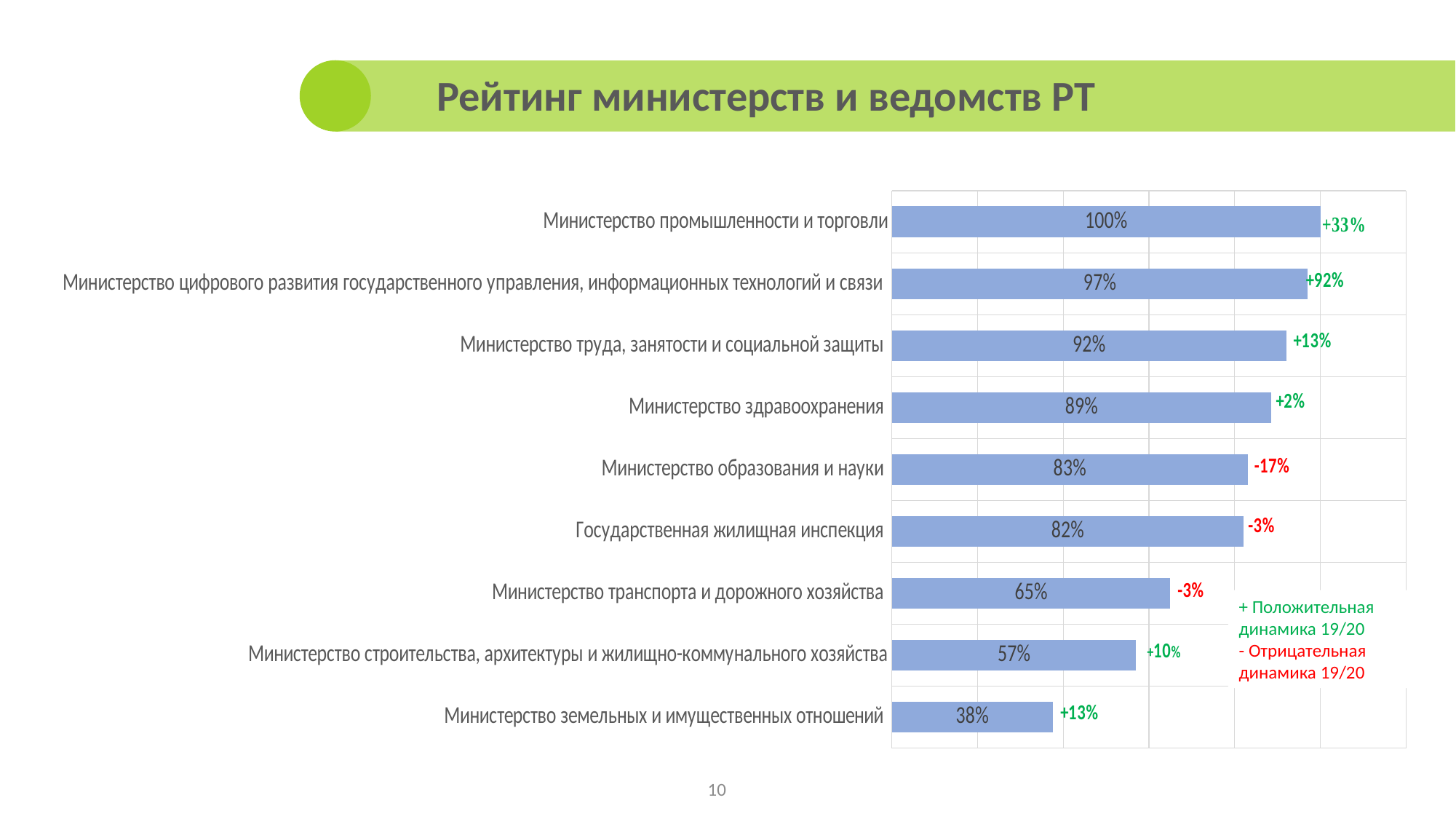
How many categories are shown in the chart? 9 What is the title of the slide containing the chart? Рейтинг министерств и ведомств РТ Which is larger: the value for Министерство цифрового развития государственного управления, информационных технологий и связи or the value for Министерство здравоохранения? Министерство цифрового развития государственного управления, информационных технологий и связи What is the value for Министерство земельных и имущественных отношений? 38% Which category has the highest value? Министерство промышленности и торговли What is the difference between the values for Министерство труда, занятости и социальной защиты and Министерство образования и науки? 9% Which category has the lowest value? Министерство земельных и имущественных отношений What kind of chart is shown on the slide? Bar chart What is the value for Министерство транспорта и дорожного хозяйства? 65% What is the value for Министерство здравоохранения? 89% What is the difference between the values for Министерство транспорта и дорожного хозяйства and Министерство строительства, архитектуры и жилищно-коммунального хозяйства? 8% What is the value for Государственная жилищная инспекция? 82%